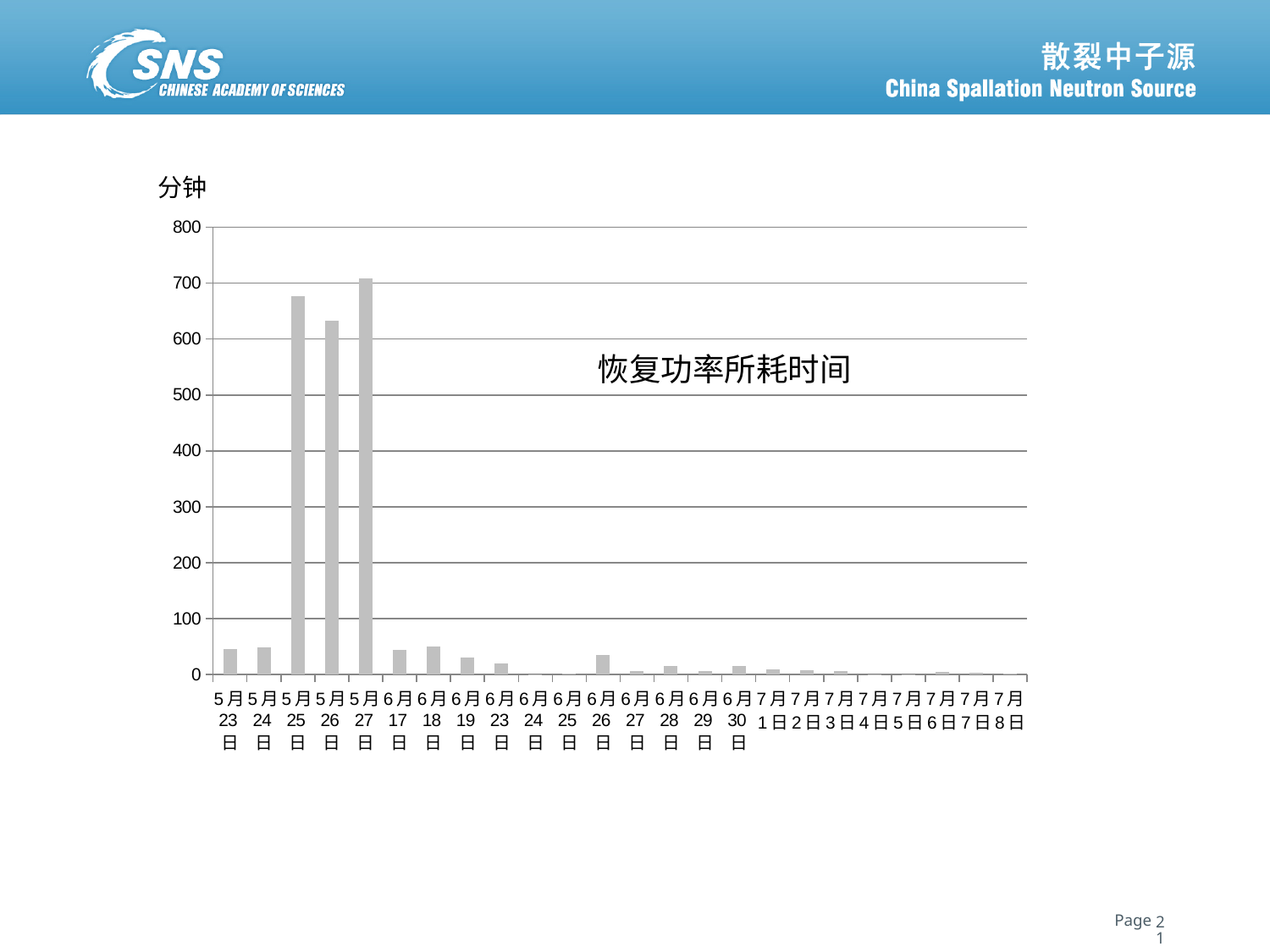
Is the value for 5月26日 greater or less than 600? greater Is the value for 5月25日 greater or less than 500? greater What unit label is shown above the vertical axis of the chart? 分钟 Which is larger, the value for 5月27日 or the value for 6月17日? 5月27日 Which is larger, the value for 5月25日 or the value for 5月26日? 5月25日 How many dates (categories) are shown along the x axis of the chart? 24 Is the value for 5月27日 greater or less than 600? greater What is the title of the chart? 恢复功率所耗时间 Which date has the highest bar in the chart? 5月27日 What kind of chart is shown on the slide? bar chart